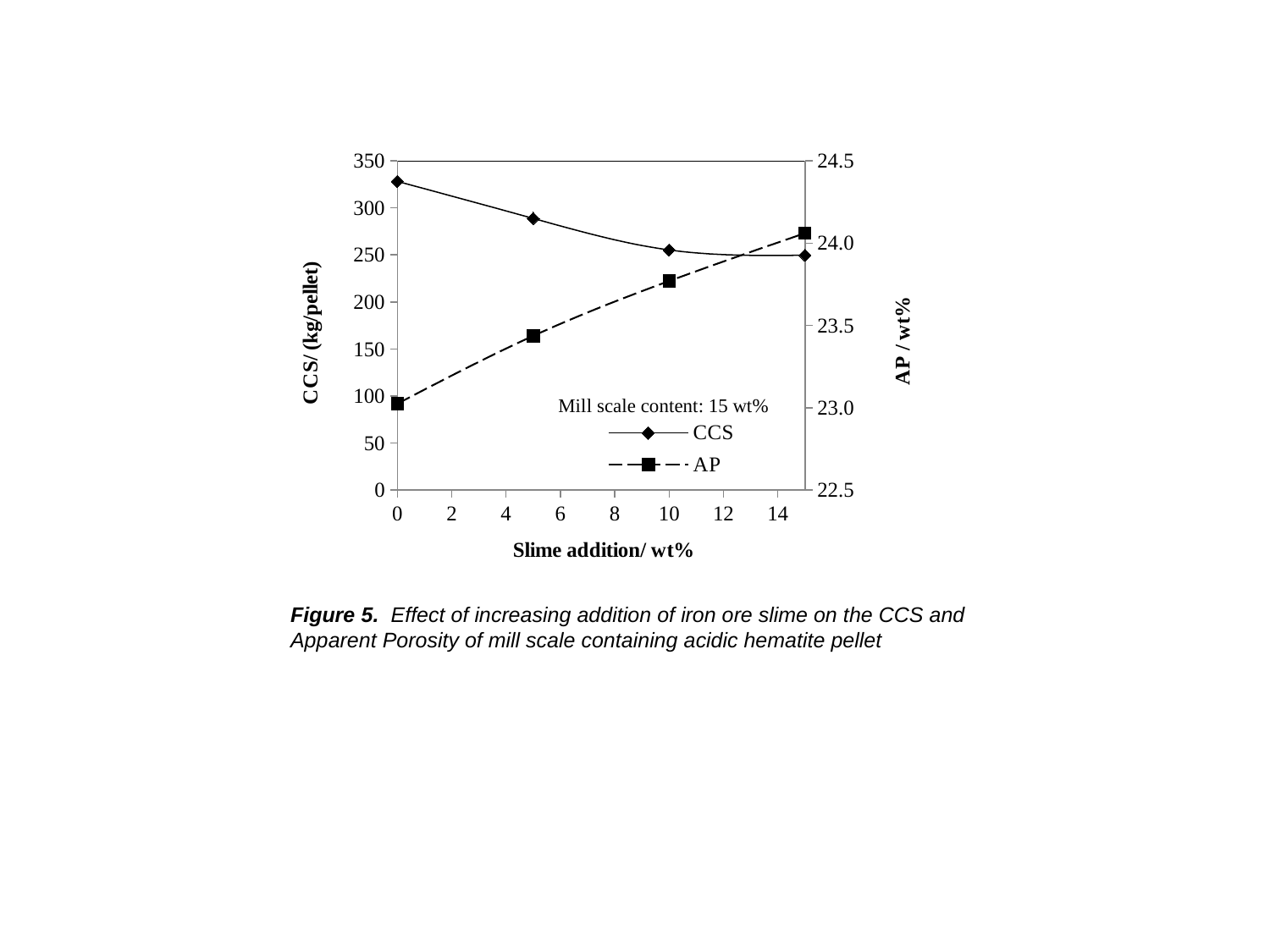
Is the CCS value at 0 wt% slime addition greater or less than 300? greater How many data points are plotted for the CCS series? 4 What kind of chart is shown on the slide? line chart What is the title of the x axis? Slime addition/ wt% Is the CCS value at 5 wt% slime addition greater or less than 250? greater At which slime addition level is the CCS value highest? 0 What mill scale content is stated in the chart annotation? 15 wt% Does the CCS value rise or fall as slime addition increases along the x axis? fall Does the AP value rise or fall as slime addition increases along the x axis? rise Is the AP value at 10 wt% slime addition greater or less than 24.0? less At which slime addition level is the AP value highest? 15 How many series does the legend list? 2